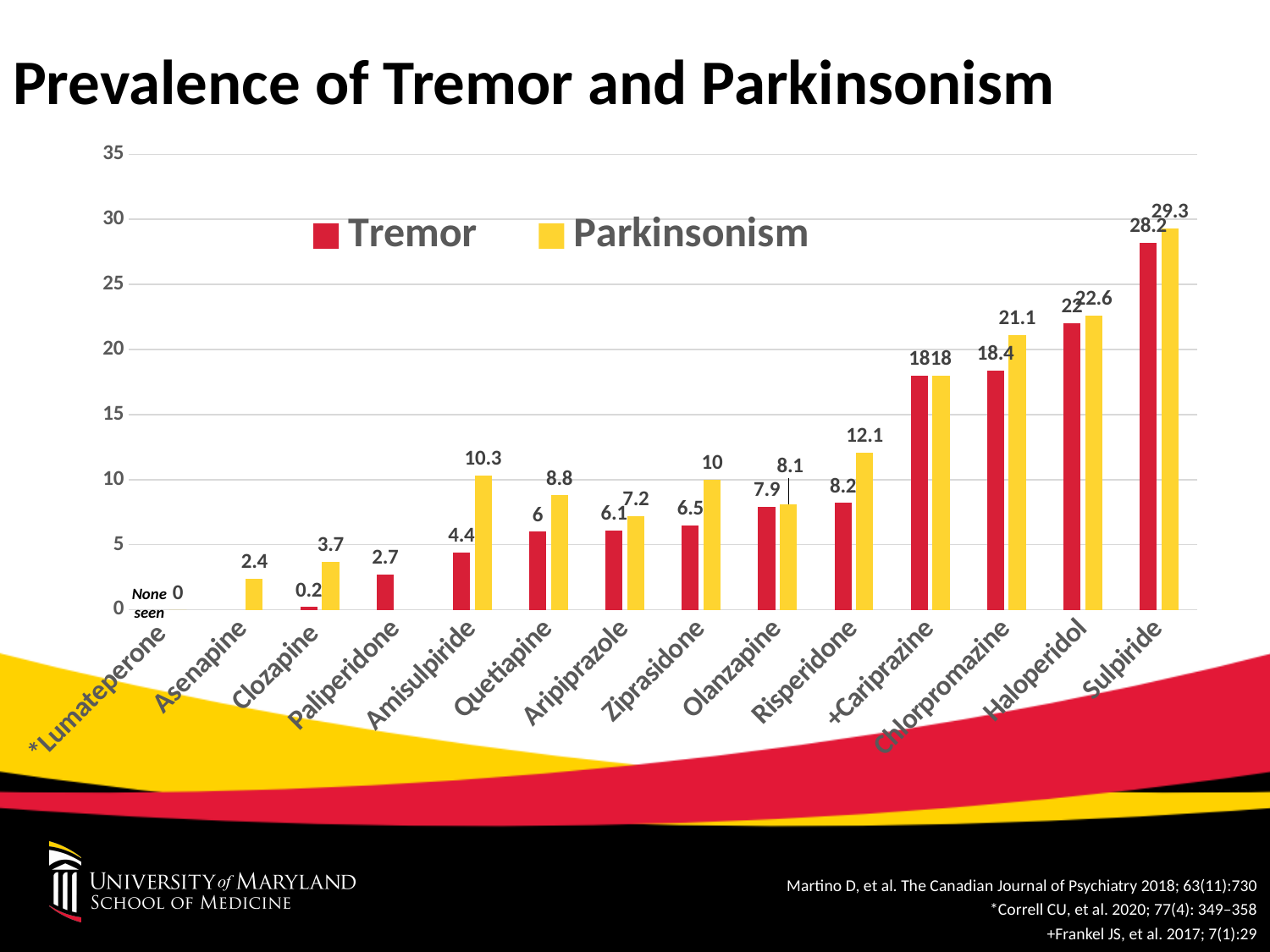
What kind of chart is shown on the slide? Bar chart Which drug has the highest Tremor value? Sulpiride Do the Parkinsonism values generally rise or fall from left to right along the x axis? Rise Which is larger for Risperidone, the Tremor value or the Parkinsonism value? Parkinsonism How many drugs are shown on the x axis? 14 How many series does the legend list? 2 What is the Parkinsonism value for Amisulpiride? 10.3 What is the Tremor value for Clozapine? 0.2 Which drug has the highest Parkinsonism value? Sulpiride What is the Parkinsonism value for Risperidone? 12.1 What is the difference between the Parkinsonism and Tremor values for Amisulpiride? 5.9 What is the Tremor value for Chlorpromazine? 18.4